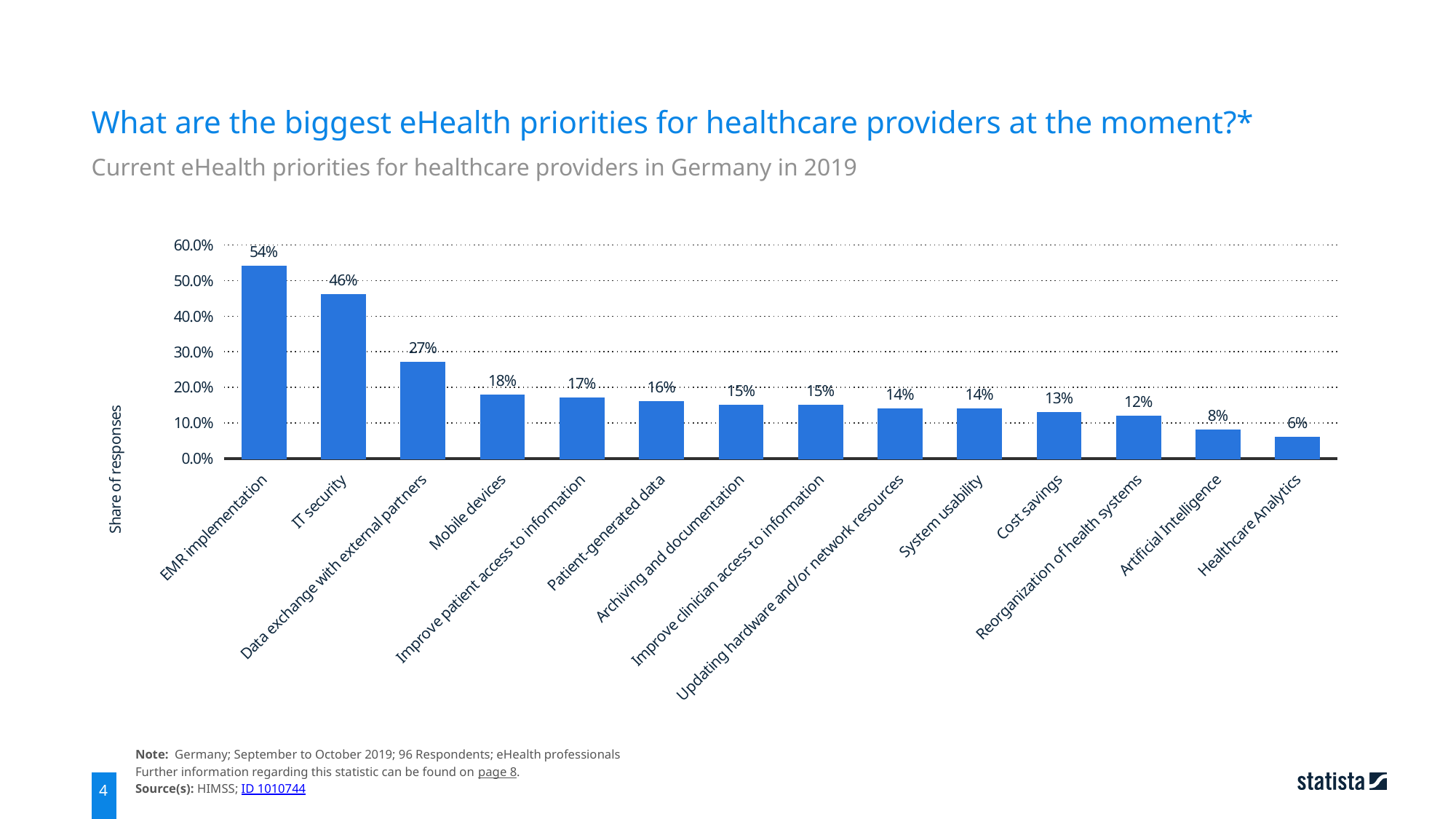
Which category has the lowest share of responses? Healthcare Analytics What is the label of the vertical axis? Share of responses What share of responses is shown for Mobile devices? 18% What share of responses is shown for Cost savings? 13% What is the difference between the shares for EMR implementation and IT security? 8% What kind of chart is shown on the slide? Bar chart What share of responses is shown for IT security? 46% Which category has the highest share of responses? EMR implementation Which has a larger share of responses, Data exchange with external partners or Mobile devices? Data exchange with external partners How many categories are shown in the chart? 14 Do the values rise or fall from left to right along the x axis? Fall What share of responses is shown for EMR implementation? 54%